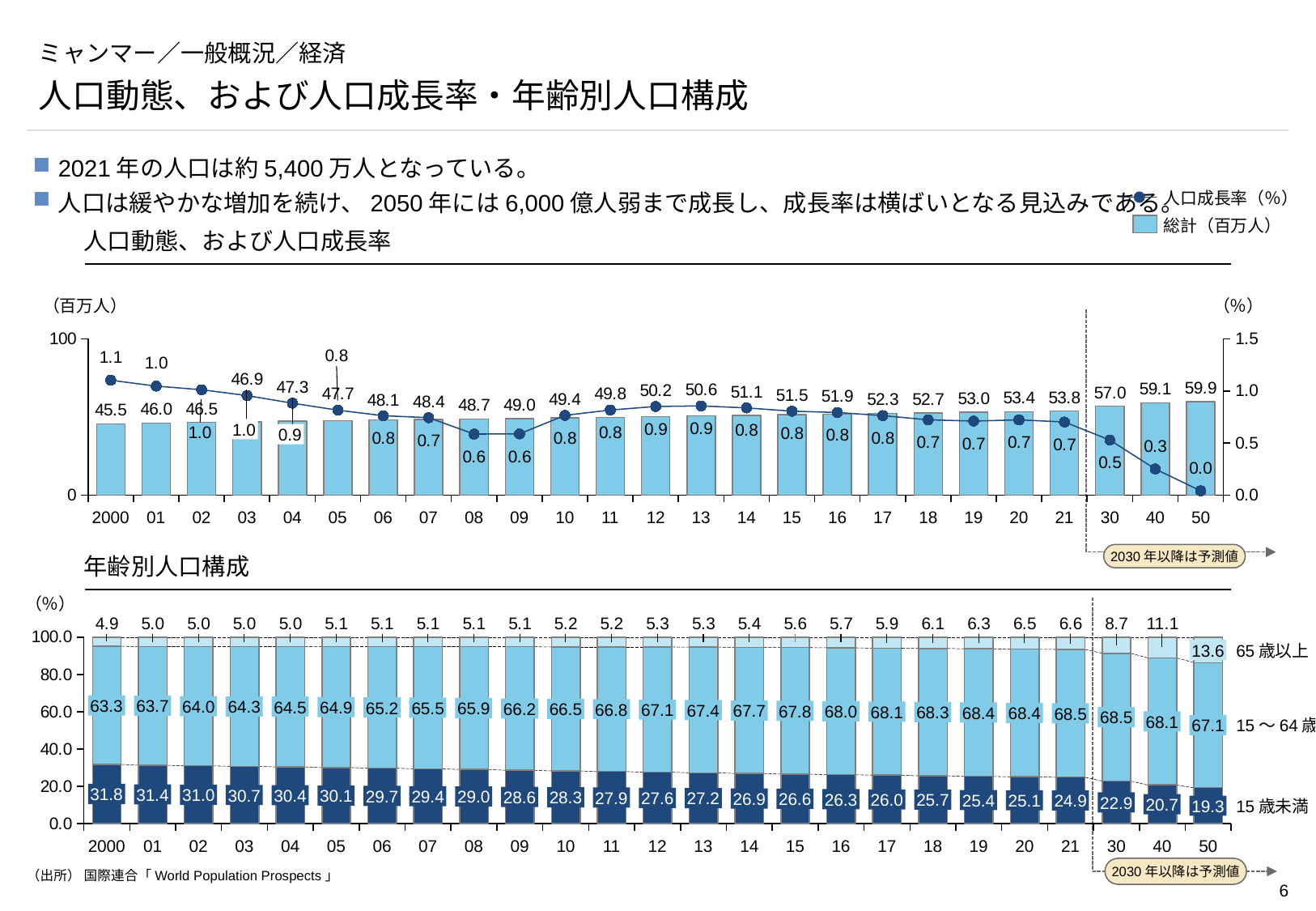
In the 年齢別人口構成 chart, what is the share of 65 歳以上 in 2050? 13.6 In the 人口動態、および人口成長率 chart, what is the difference in total population between 2050 and 2000? 14.4 In the 年齢別人口構成 chart, which is larger in 2021: the share of 15 歳未満 or the share of 65 歳以上? 15 歳未満 In the 人口動態、および人口成長率 chart, what is the population growth rate (%) for 2000? 1.1 In the 人口動態、および人口成長率 chart, which year has the lowest population growth rate? 50 How many series does the legend of the 人口動態、および人口成長率 chart list? 2 How many years (categories) are shown on the x axis of the 年齢別人口構成 chart? 25 In the 人口動態、および人口成長率 chart, which year has the highest total population? 50 In the 人口動態、および人口成長率 chart, does the total population rise or fall from 2000 to 2050? rise In the 人口動態、および人口成長率 chart, what is the total population (百万人) for 2021? 53.8 In the 年齢別人口構成 chart, what is the share of 15 歳未満 in 2000? 31.8 What kind of chart is the 年齢別人口構成 chart? stacked bar chart